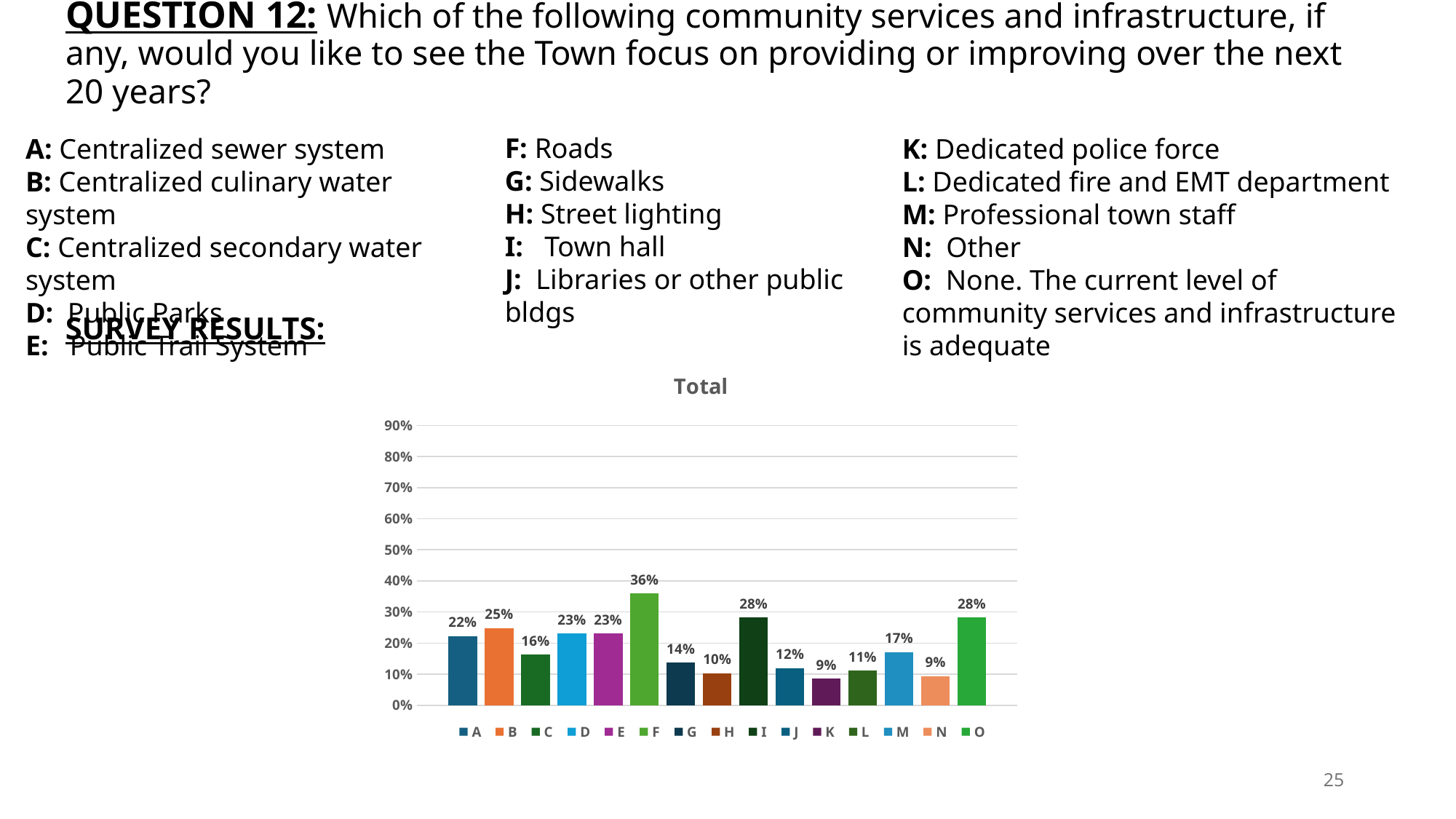
How many categories are shown in the Total chart? 15 What is the value for F in the Total chart? 36% What is the value for B in the Total chart? 25% What is the title of the chart on the slide? Total What is the value for M in the Total chart? 17% Which category has the highest value in the Total chart? F What kind of chart is shown on the slide? Bar chart Is the value for O in the Total chart greater or less than 20%? greater How many entries does the legend of the Total chart list? 15 What is the difference between the values for F and A in the Total chart? 14% What is the difference between the values for D and H in the Total chart? 13% Which is larger in the Total chart, the value for I or the value for G? I